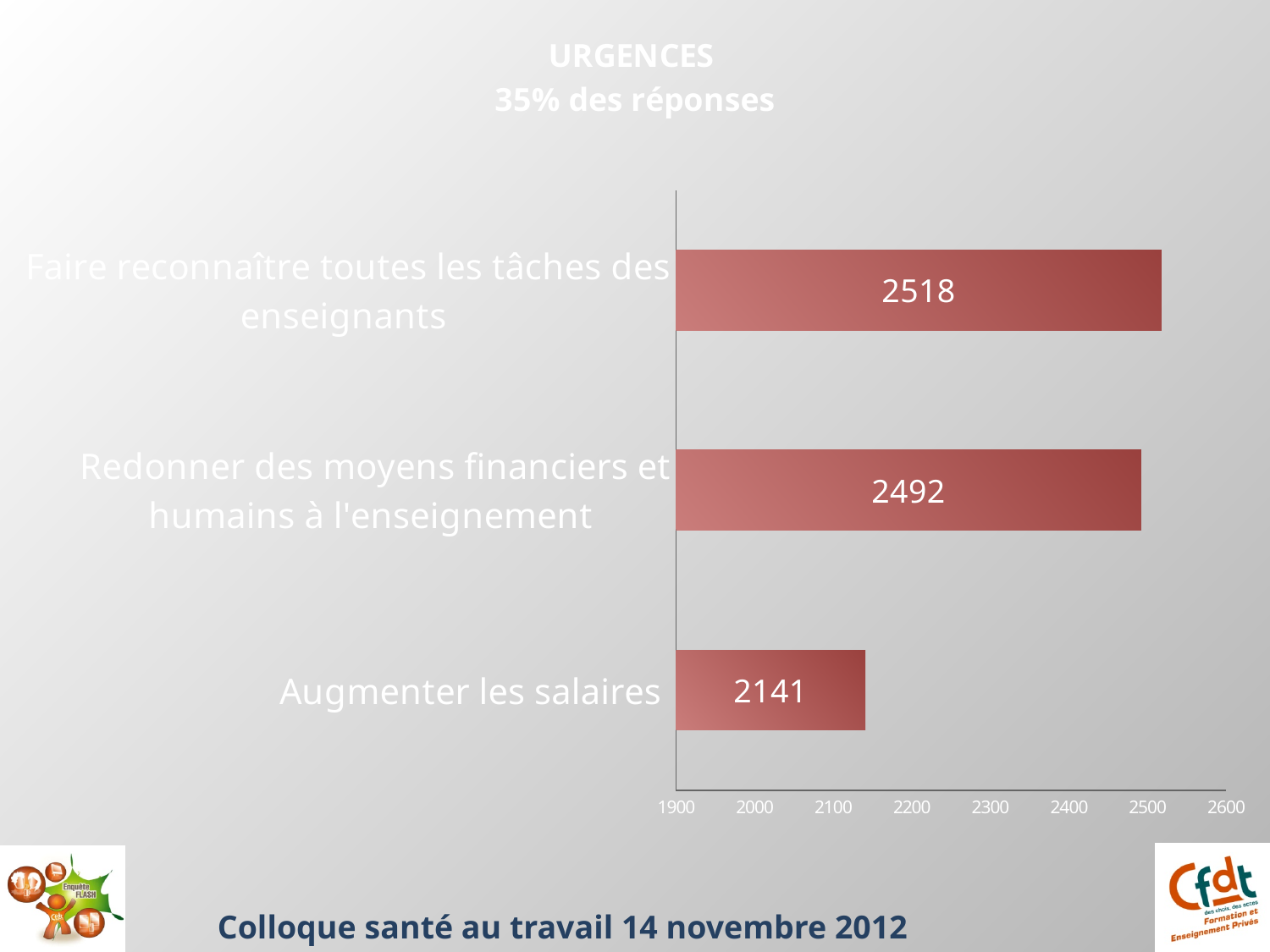
What is the value for "Augmenter les salaires"? 2141 What kind of chart is shown on the slide? bar chart How many categories are shown in the chart? 3 Which is larger, the value for "Redonner des moyens financiers et humains à l'enseignement" or the value for "Augmenter les salaires"? Redonner des moyens financiers et humains à l'enseignement What is the difference between the values for "Faire reconnaître toutes les tâches des enseignants" and "Augmenter les salaires"? 377 Which category has the highest value? Faire reconnaître toutes les tâches des enseignants What is the value for "Redonner des moyens financiers et humains à l'enseignement"? 2492 Which category has the lowest value? Augmenter les salaires What is the title of the chart? URGENCES 35% des réponses What is the value for "Faire reconnaître toutes les tâches des enseignants"? 2518 Is the value for "Augmenter les salaires" greater or less than 2200? less What is the difference between the values for "Redonner des moyens financiers et humains à l'enseignement" and "Augmenter les salaires"? 351